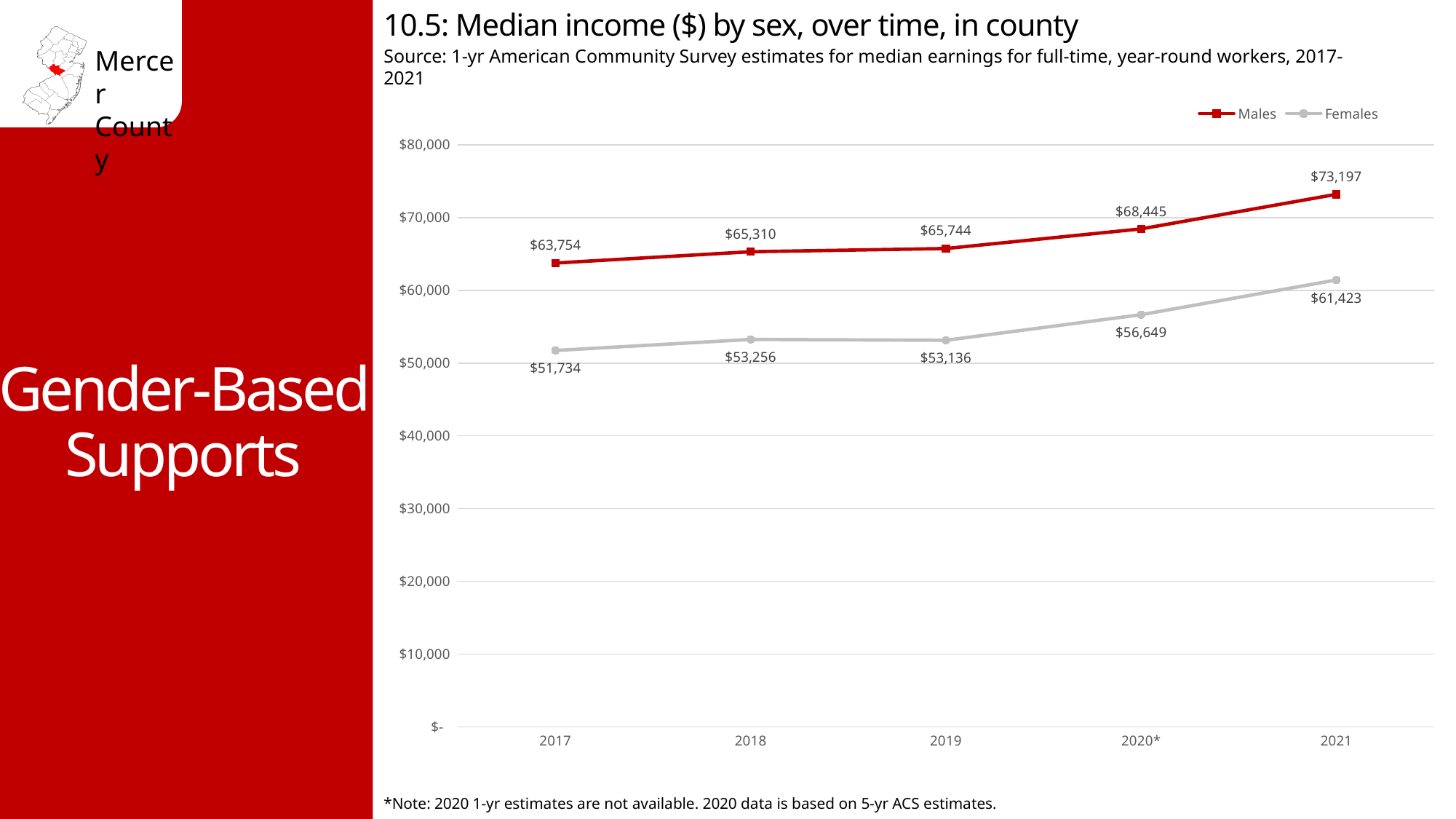
What is the difference between male and female median income in 2021? $11,774 In which year was the median income for males highest? 2021 What kind of chart is shown on the slide? Line chart How many series does the legend list? 2 Which was higher in 2019, the median income for males or for females? Males Is the median income for females in 2018 greater or less than $60,000? less In which year was the median income for females lowest? 2017 How many years are shown on the x axis? 5 What is the difference between male median income in 2021 and in 2017? $9,443 What was the median income for females in 2020*? $56,649 What was the median income for males in 2017? $63,754 What was the median income for females in 2021? $61,423